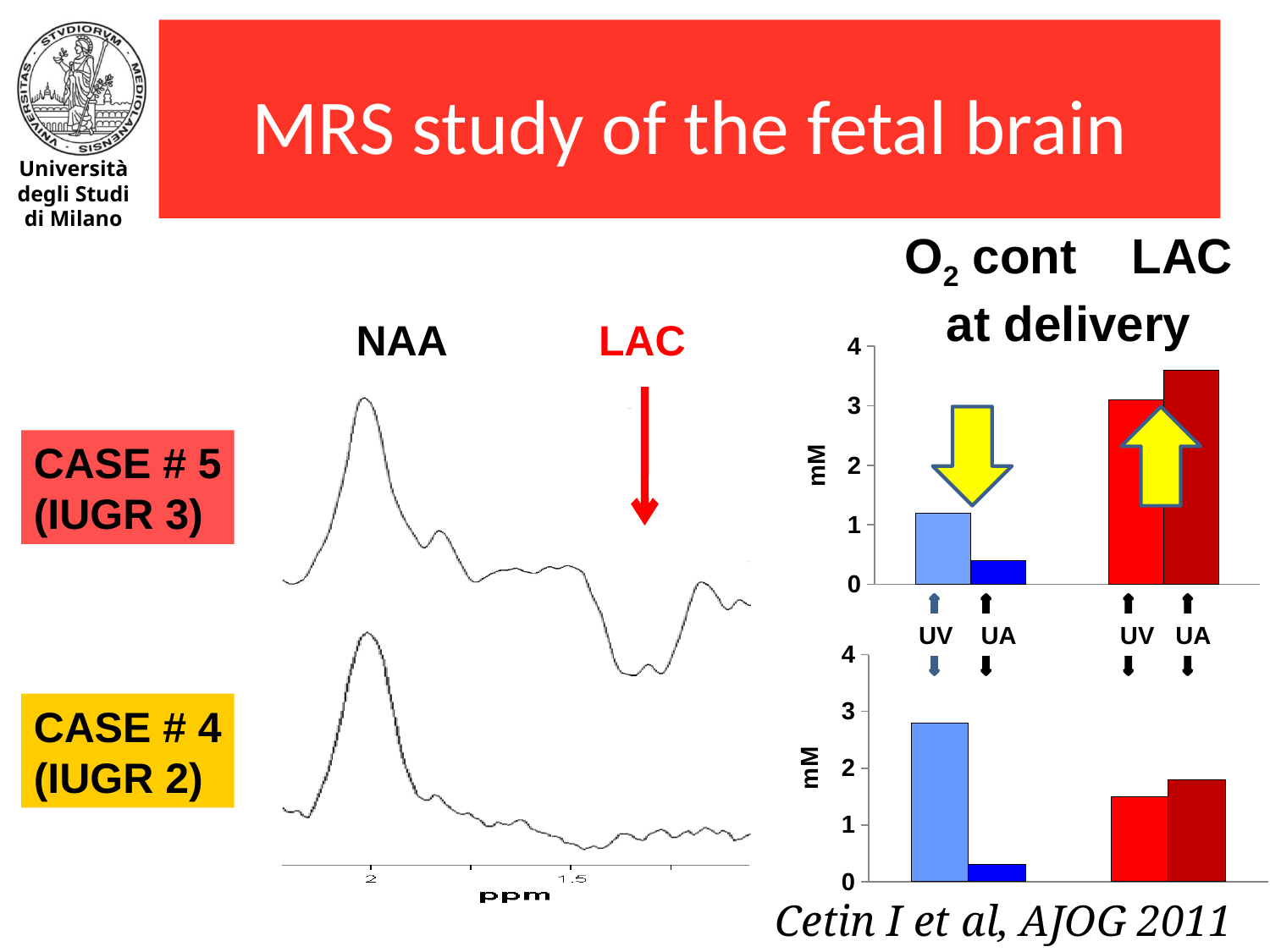
In the top bar chart (Case # 5), which bar is the highest? UA LAC In the bottom bar chart (Case # 4), which bar is the lowest? UA O2 cont What kind of chart is the top chart on the right (Case # 5)? bar chart How many bars are plotted in the bottom bar chart (Case # 4)? 4 In the top bar chart (Case # 5), is the LAC value for UA greater or less than 3? greater In the bottom bar chart (Case # 4), which is larger, the O2 cont value for UV or the O2 cont value for UA? UV What unit is shown on the y axis of the bar charts? mM In the top bar chart (Case # 5), is the O2 cont value for UV greater or less than 2? less In the bottom bar chart (Case # 4), is the O2 cont value for UV greater or less than 2? greater In the top bar chart (Case # 5), which is larger, the LAC value for UV or the LAC value for UA? UA